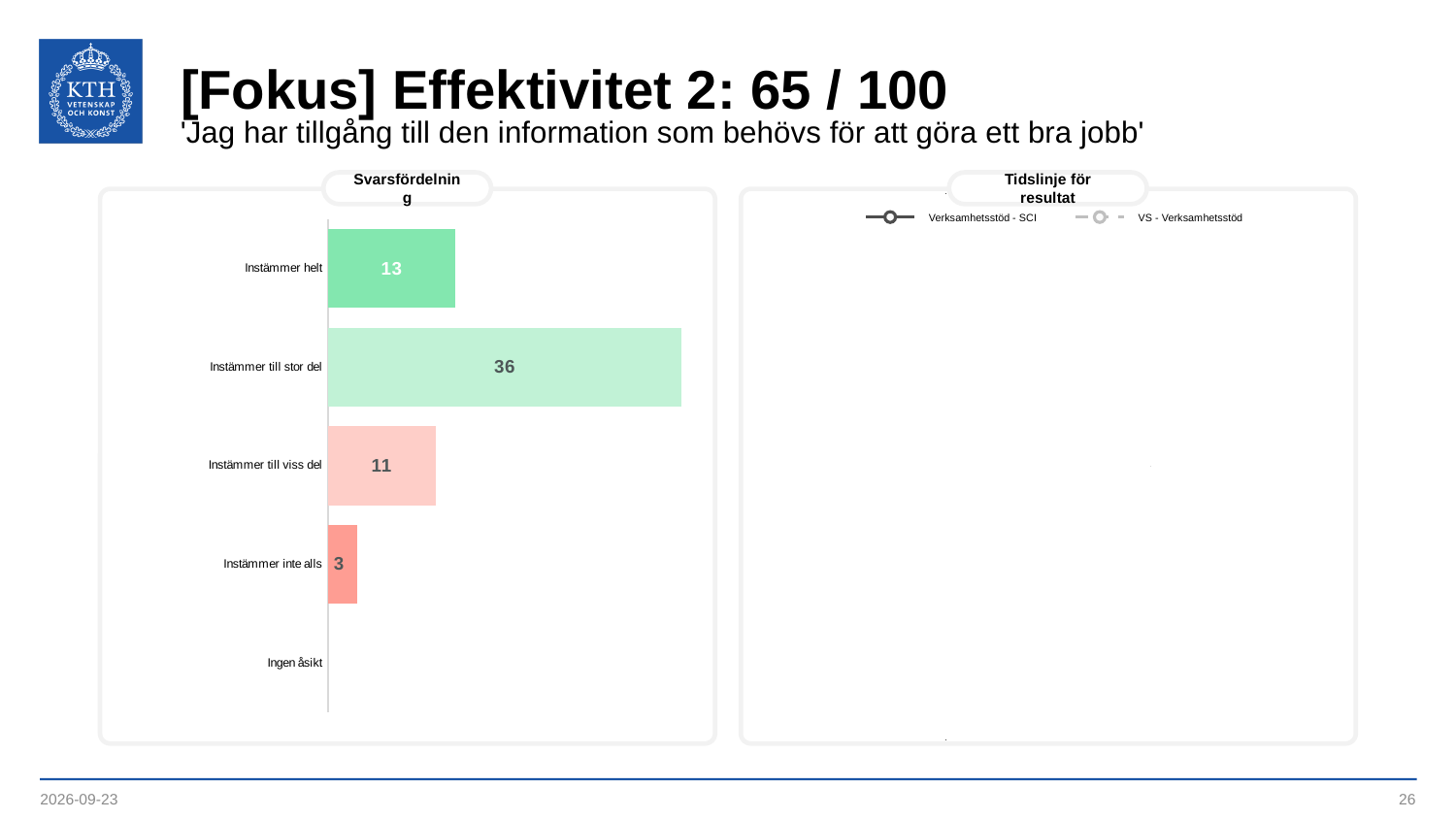
In the Svarsfördelning chart, what is the difference between 'Instämmer till stor del' and 'Instämmer helt'? 23 In the Svarsfördelning chart, what is the value for 'Instämmer helt'? 13 What are the two legend entries in the 'Tidslinje för resultat' chart? Verksamhetsstöd - SCI and VS - Verksamhetsstöd In the Svarsfördelning chart, what is the value for 'Instämmer till stor del'? 36 What kind of chart is the Svarsfördelning chart? Bar chart How many series does the legend of the 'Tidslinje för resultat' chart list? 2 In the Svarsfördelning chart, what is the value for 'Instämmer inte alls'? 3 How many categories are shown on the y axis of the Svarsfördelning chart? 5 In the Svarsfördelning chart, what is the value for 'Instämmer till viss del'? 11 In the Svarsfördelning chart, what is the difference between 'Instämmer till viss del' and 'Instämmer inte alls'? 8 In the Svarsfördelning chart, which is larger: 'Instämmer helt' or 'Instämmer till viss del'? Instämmer helt In the Svarsfördelning chart, which category has the highest value? Instämmer till stor del